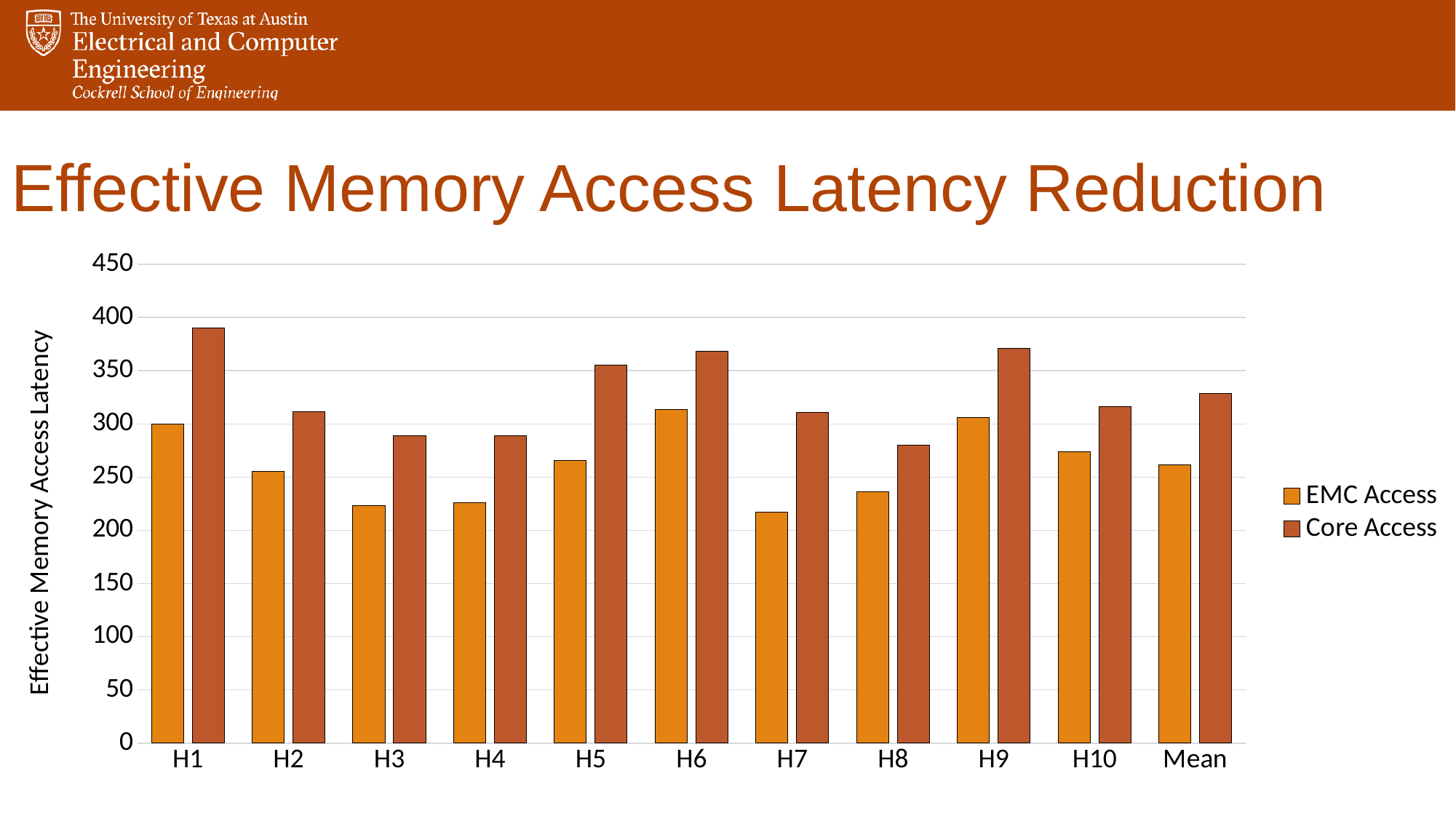
Which is larger, the Core Access value for H5 or for H2? H5 Is the Core Access value for Mean greater or less than 300? greater Is the EMC Access value for H7 greater or less than 250? less How many series does the legend list? 2 Is the Core Access value for H9 greater or less than 350? greater How many categories are shown on the x axis? 11 Which is larger, the EMC Access value for H1 or for H2? H1 Which category has the highest Core Access value? H1 What kind of chart is shown on the slide? bar chart What is the label on the y axis? Effective Memory Access Latency